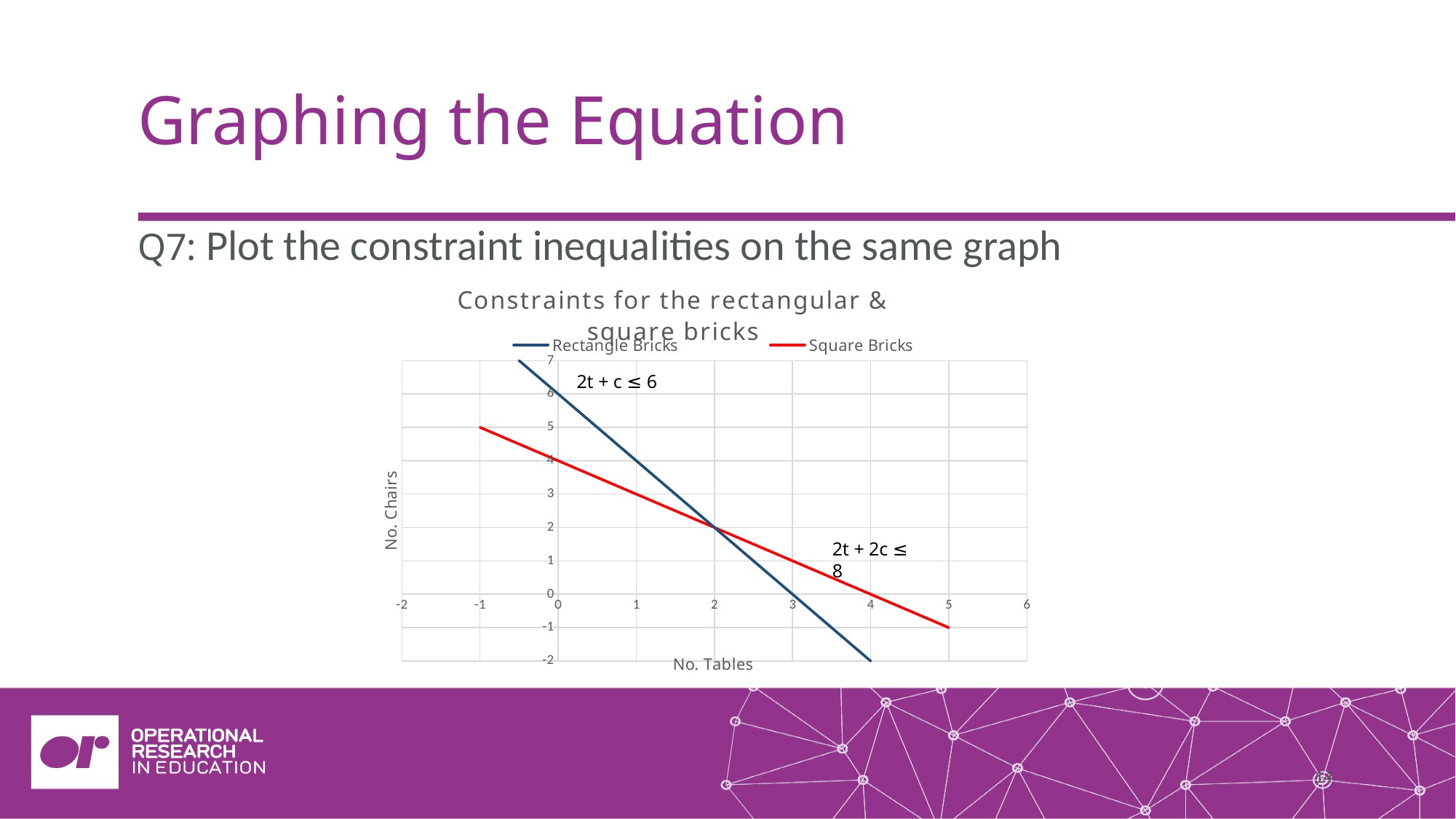
What are the two series named in the legend? Rectangle Bricks and Square Bricks How many series does the legend list? 2 At what point do the Rectangle Bricks and Square Bricks lines intersect? (2, 2) What is the label on the vertical axis? No. Chairs At what value of No. Tables does the Square Bricks line cross zero on the No. Chairs axis? 4 At No. Tables = 3, which line is higher, Rectangle Bricks or Square Bricks? Square Bricks What is the value of the Square Bricks line when No. Tables is 0? 4 At No. Tables = 1, which line is higher, Rectangle Bricks or Square Bricks? Rectangle Bricks At what value of No. Tables does the Rectangle Bricks line cross zero on the No. Chairs axis? 3 Do the lines rise or fall as No. Tables increases? fall What kind of chart is shown on the slide? line chart What is the value of the Rectangle Bricks line when No. Tables is 0? 6